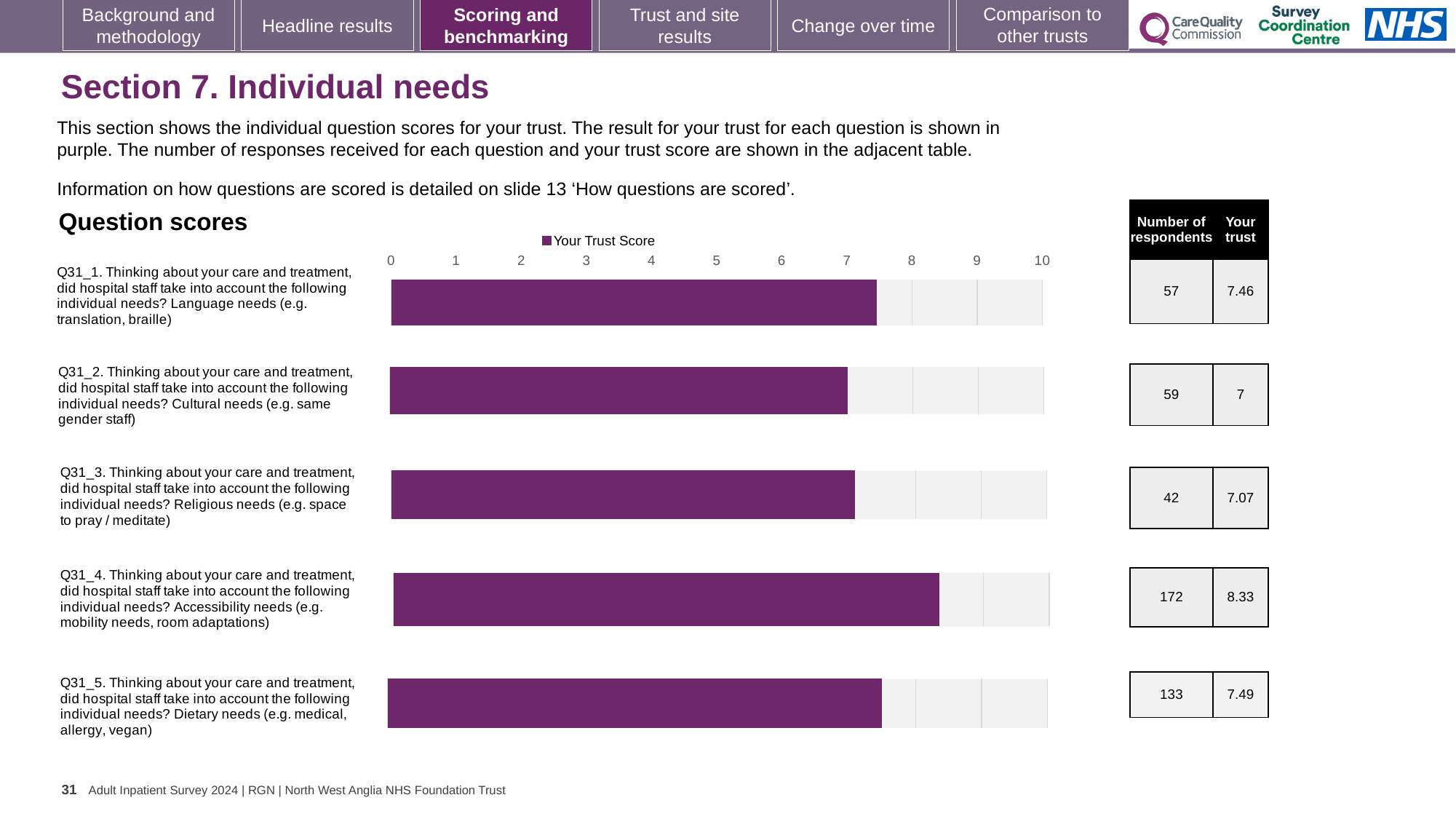
Which has a higher trust score, Q31_1 (Language needs) or Q31_3 (Religious needs)? Q31_1 (Language needs) How many series does the chart legend list? 1 Which question has the highest trust score? Q31_4 (Accessibility needs) What is the trust score for Q31_4 (Accessibility needs)? 8.33 What kind of chart is shown on the slide? Bar chart What is the trust score for Q31_5 (Dietary needs)? 7.49 Which question has the lowest trust score? Q31_2 (Cultural needs) What is the trust score for Q31_2 (Cultural needs)? 7 What is the difference between the trust scores for Q31_4 (Accessibility needs) and Q31_2 (Cultural needs)? 1.33 How many questions are plotted in the chart? 5 Is the trust score for Q31_4 (Accessibility needs) greater or less than 8? greater What is the name of the series shown in the chart legend? Your Trust Score